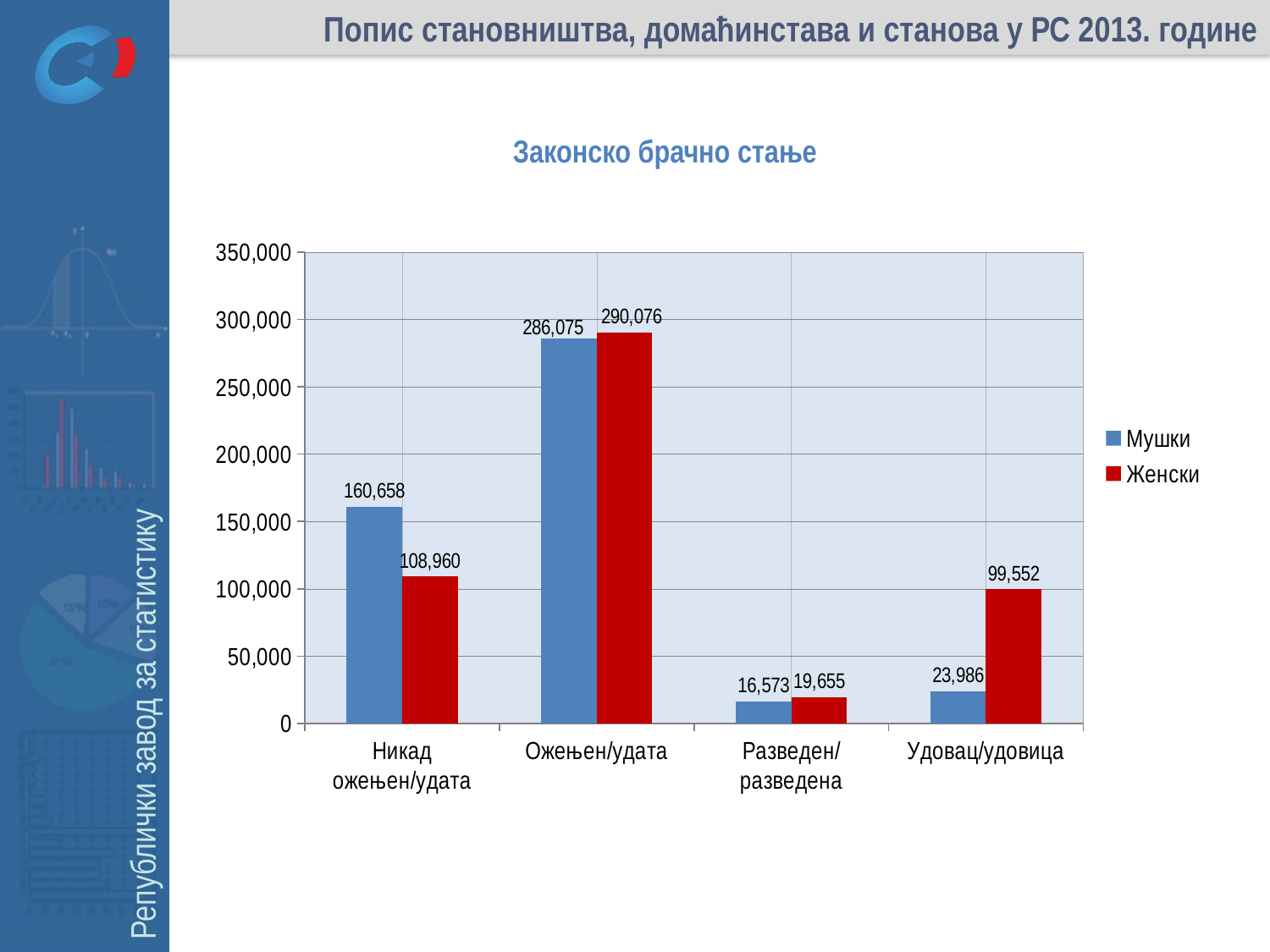
How many series does the legend list? 2 What type of chart is shown on the slide? Bar chart What is the difference between the Женски and Мушки values in the Удовац/удовица category? 75,566 Which category has the lowest value for Женски? Разведен/разведена In the Никад ожењен/удата category, which series has the larger value, Мушки or Женски? Мушки What is the value for Женски in the Ожењен/удата category? 290,076 What is the value for Мушки in the Никад ожењен/удата category? 160,658 What is the difference between the Мушки and Женски values in the Никад ожењен/удата category? 51,698 What is the value for Мушки in the Разведен/разведена category? 16,573 How many categories are shown on the x axis? 4 Which category has the highest value for Мушки? Ожењен/удата What is the value for Женски in the Удовац/удовица category? 99,552